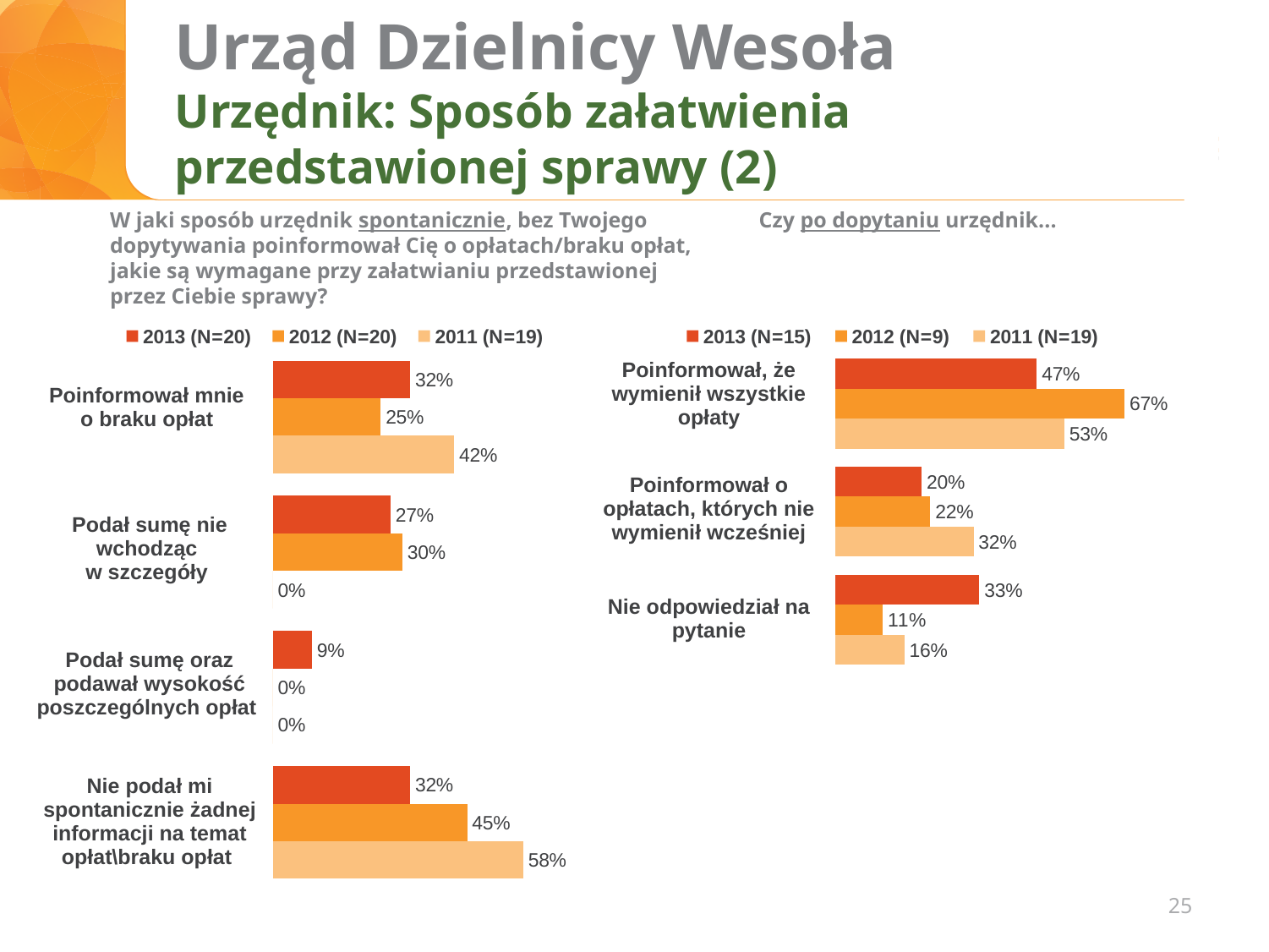
In the right chart, which series has the lowest value for "Nie odpowiedział na pytanie"? 2012 (N=9) In the right chart, what is the 2012 (N=9) value for "Poinformował, że wymienił wszystkie opłaty"? 67% In the left chart, how many categories are shown? 4 In the left chart, what is the 2011 (N=19) value for "Poinformował mnie o braku opłat"? 42% What type of chart is the right chart? bar chart In the left chart, what is the difference between the 2011 (N=19) and 2013 (N=20) values for "Nie podał mi spontanicznie żadnej informacji na temat opłat\braku opłat"? 26% In the left chart, what is the 2013 (N=20) value for "Podał sumę oraz podawał wysokość poszczególnych opłat"? 9% In the right chart, is the 2013 (N=15) value for "Poinformował, że wymienił wszystkie opłaty" larger or smaller than the 2011 (N=19) value? smaller In the right chart, how many series does the legend list? 3 In the left chart, which category has the highest 2011 (N=19) value? Nie podał mi spontanicznie żadnej informacji na temat opłat\braku opłat In the left chart, what is the 2012 (N=20) value for "Nie podał mi spontanicznie żadnej informacji na temat opłat\braku opłat"? 45% In the right chart, what is the 2013 (N=15) value for "Nie odpowiedział na pytanie"? 33%